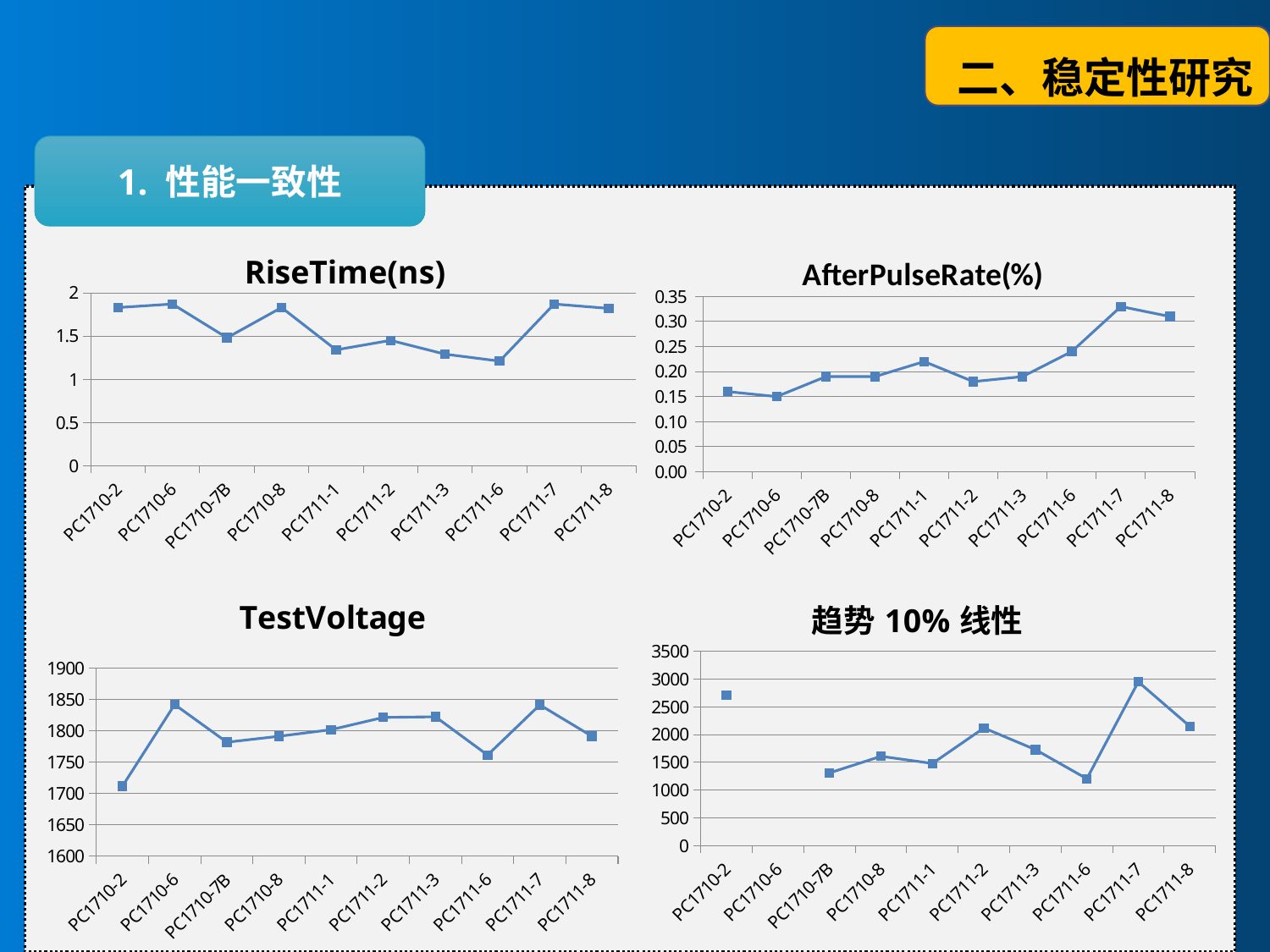
What kind of chart is the RiseTime(ns) chart? line chart In the RiseTime(ns) chart, is the value for PC1710-2 greater or less than 1.5? greater In the RiseTime(ns) chart, is the value for PC1711-6 greater or less than 1.5? less How many categories are shown on the x axis of the TestVoltage chart? 10 In the 趋势 10% 线性 chart, which is larger, the value for PC1711-2 or the value for PC1711-3? PC1711-2 In the TestVoltage chart, is the value for PC1710-6 greater or less than 1800? greater In the 趋势 10% 线性 chart, which category has the highest value? PC1711-7 In the RiseTime(ns) chart, which category has the lowest value? PC1711-6 In the AfterPulseRate(%) chart, which category has the highest value? PC1711-7 In the TestVoltage chart, which category has the lowest value? PC1710-2